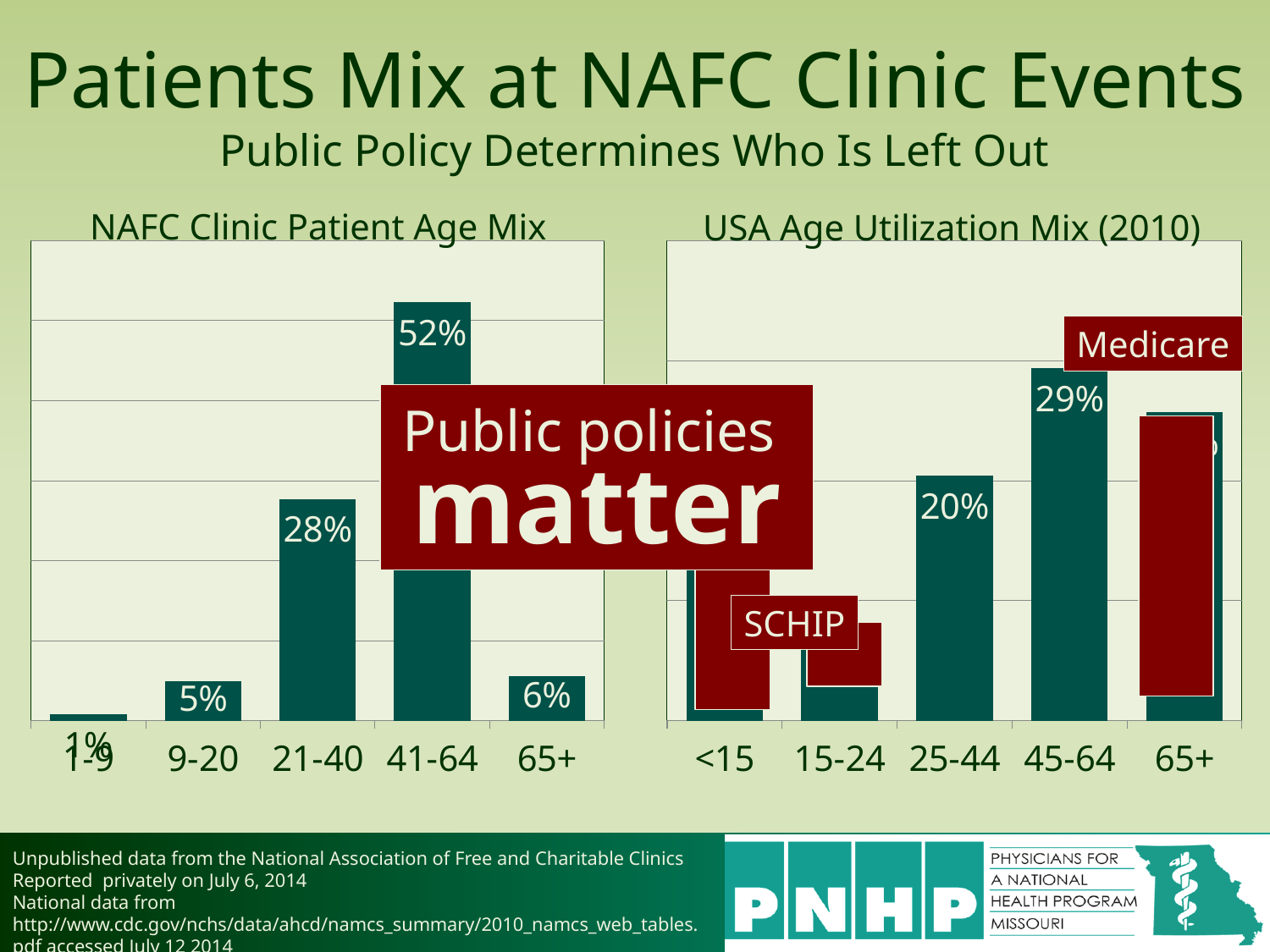
In the NAFC Clinic Patient Age Mix chart, what is the value for the 65+ age group? 6% In the NAFC Clinic Patient Age Mix chart, which age group has the highest value? 41-64 In the USA Age Utilization Mix (2010) chart, what is the value for the 25-44 age group? 20% In the NAFC Clinic Patient Age Mix chart, what is the value for the 21-40 age group? 28% In the NAFC Clinic Patient Age Mix chart, which age group has the lowest value? 1-9 In the USA Age Utilization Mix (2010) chart, what is the difference between the 45-64 and 25-44 values? 9% How many age groups are shown in the USA Age Utilization Mix (2010) chart? 5 In the NAFC Clinic Patient Age Mix chart, what is the difference between the 41-64 and 21-40 values? 24% In the USA Age Utilization Mix (2010) chart, what is the value for the 45-64 age group? 29% How many age groups are shown in the NAFC Clinic Patient Age Mix chart? 5 What kind of chart is the NAFC Clinic Patient Age Mix chart? bar chart In the NAFC Clinic Patient Age Mix chart, what is the value for the 41-64 age group? 52%